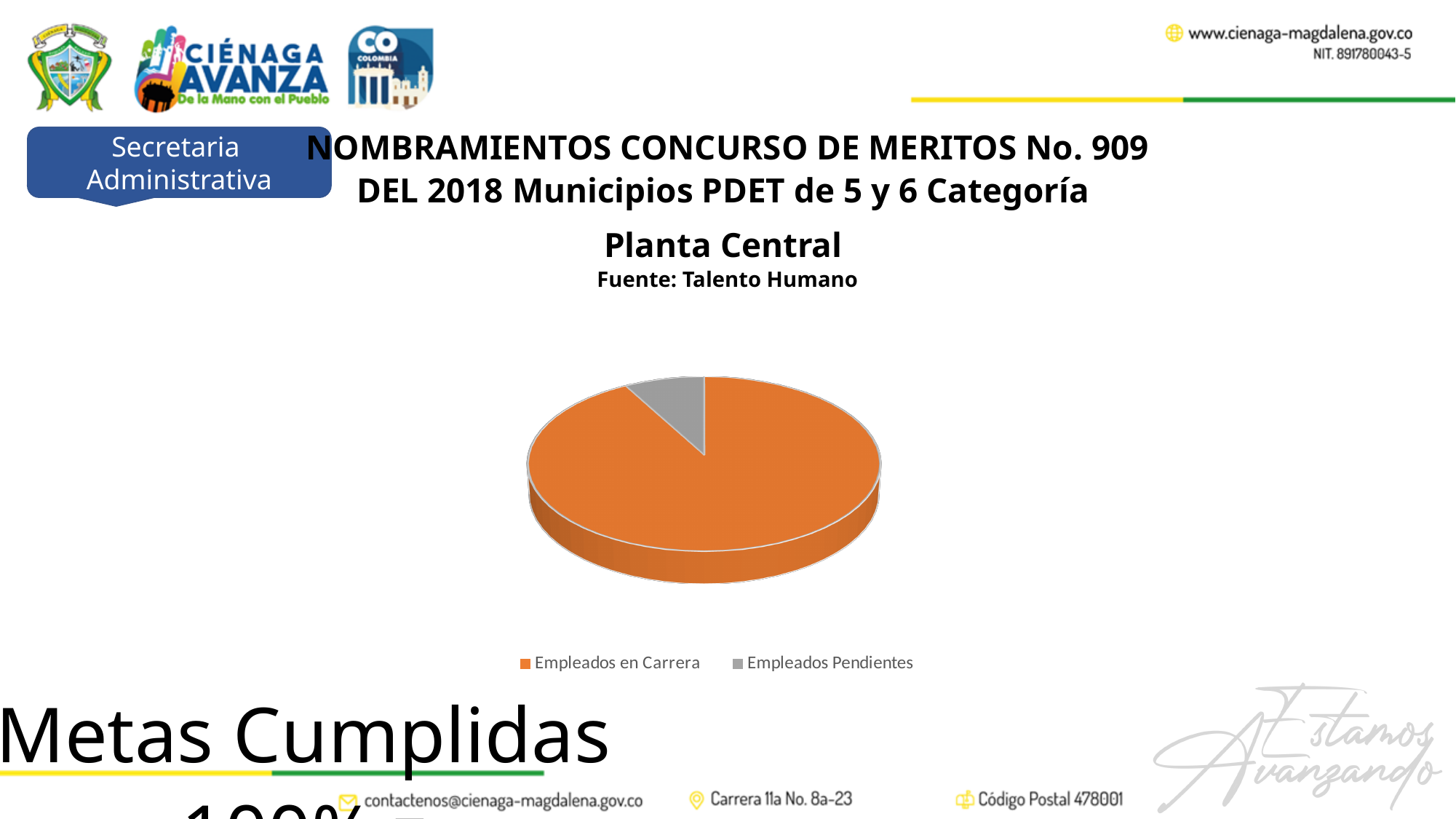
Which category has the largest slice in the pie chart? Empleados en Carrera What is the title of the pie chart? Planta Central Which slice is larger, Empleados en Carrera or Empleados Pendientes? Empleados en Carrera How many entries does the legend of the pie chart list? 2 What kind of chart is shown on the slide? pie chart How many slices does the pie chart have? 2 What colour is the Empleados Pendientes slice in the pie chart? gray Which category has the smallest slice in the pie chart? Empleados Pendientes